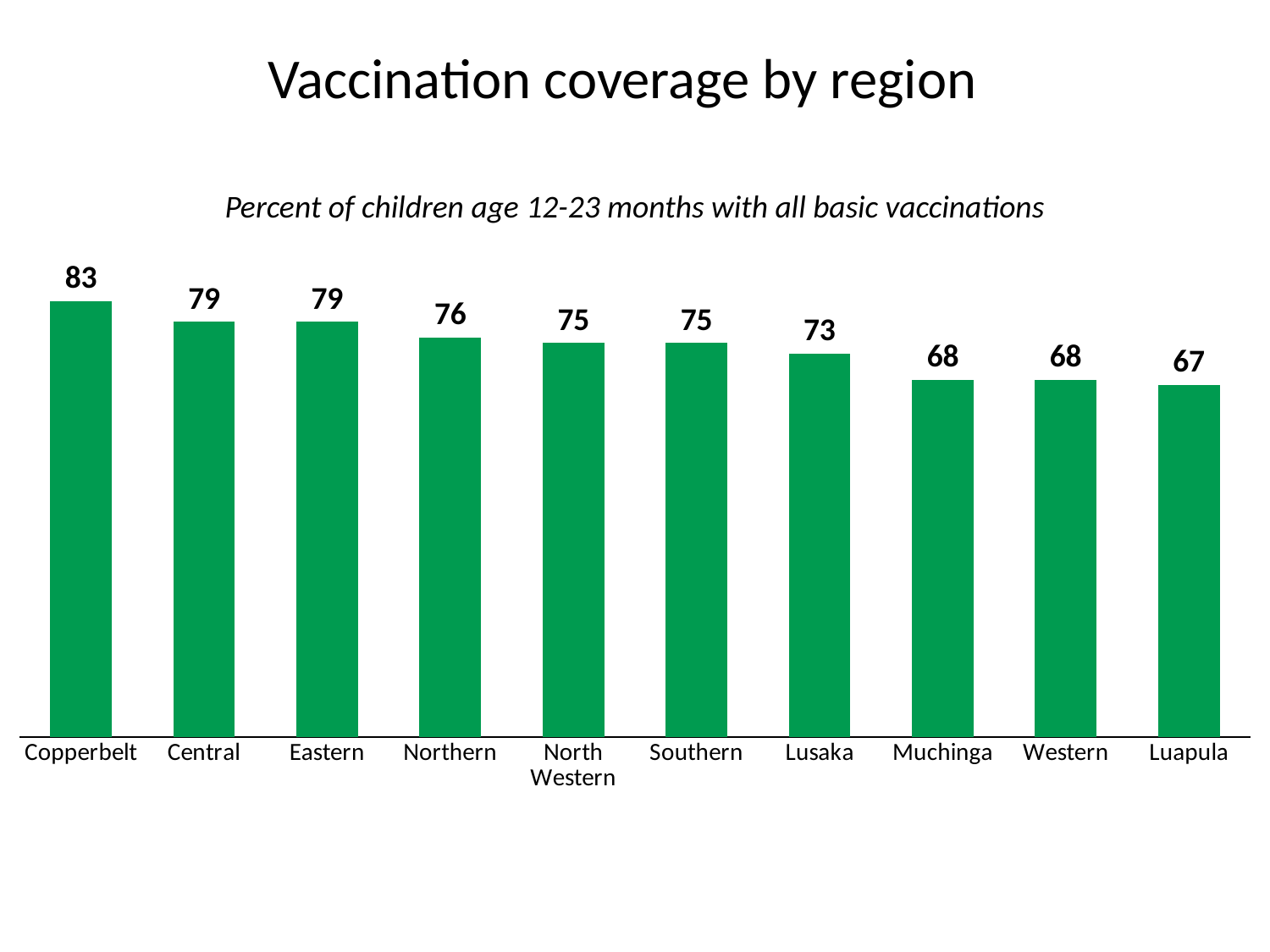
What is the title of the chart? Vaccination coverage by region How many regions are shown in the chart? 10 Which has a higher value, Northern or Western? Northern What is the value shown for Lusaka? 73 Which region has the highest vaccination coverage? Copperbelt What is the vaccination coverage value for Copperbelt? 83 What kind of chart is shown on the slide? Bar chart What is the difference between the values for Copperbelt and Luapula? 16 Do the values rise or fall from left to right across the regions? Fall Which region has the lowest vaccination coverage? Luapula What is the difference between the values for Central and Lusaka? 6 What is the value shown for Muchinga? 68